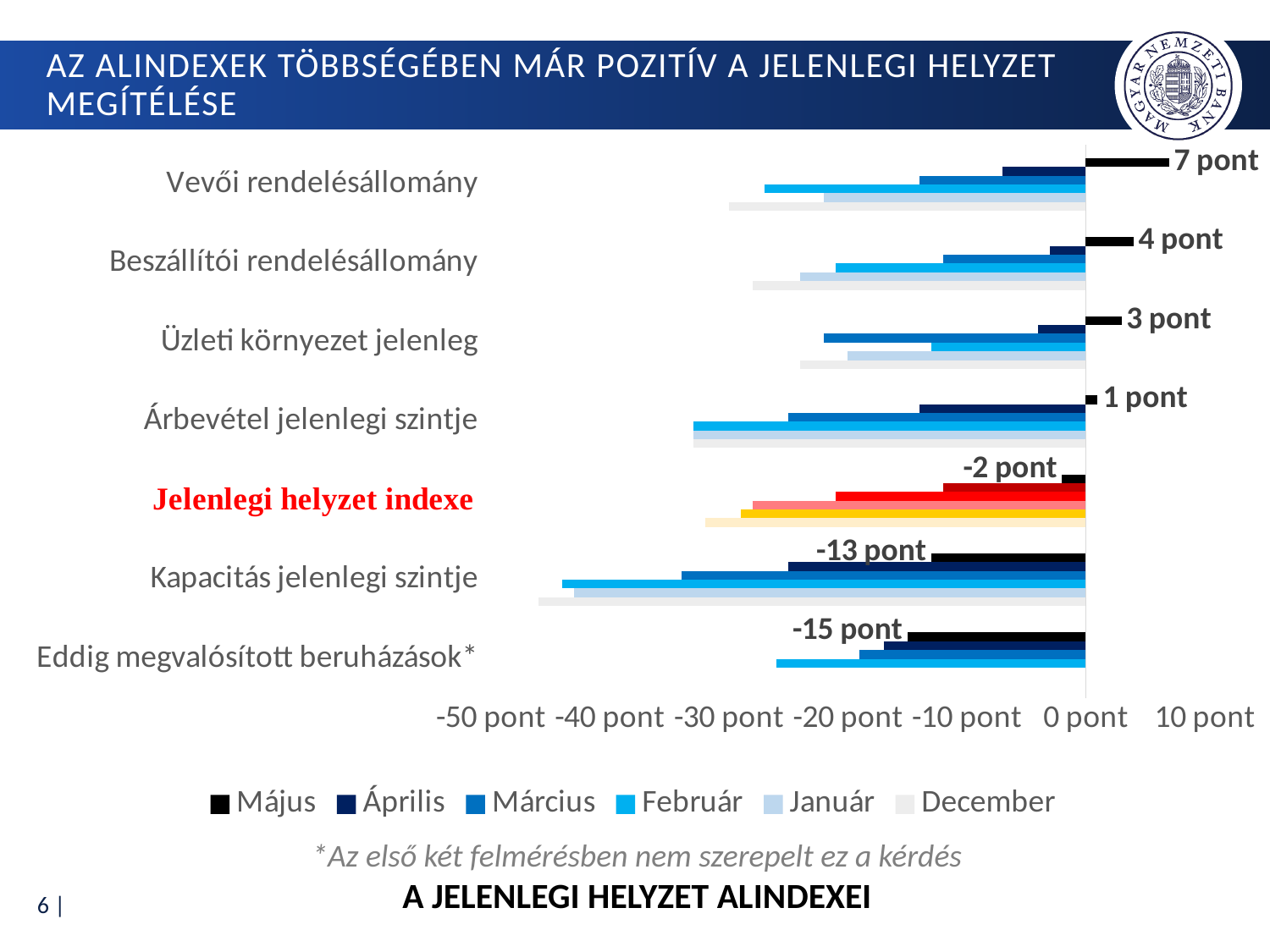
How many categories are shown on the chart? 7 Which has the larger Május value: Beszállítói rendelésállomány or Üzleti környezet jelenleg? Beszállítói rendelésállomány Which category has the lowest Május value? Eddig megvalósított beruházások* Which category has the highest Május value? Vevői rendelésállomány What is the Május value for Vevői rendelésállomány? 7 pont What is the difference between the Május values for Vevői rendelésállomány and Beszállítói rendelésállomány? 3 pont Is the Február value for Kapacitás jelenlegi szintje greater or less than -40 pont? less What is the Május value for Kapacitás jelenlegi szintje? -13 pont How many series does the legend list? 6 What is the Május value for Eddig megvalósított beruházások*? -15 pont What kind of chart is shown on the slide? bar chart What is the Május value for Jelenlegi helyzet indexe? -2 pont